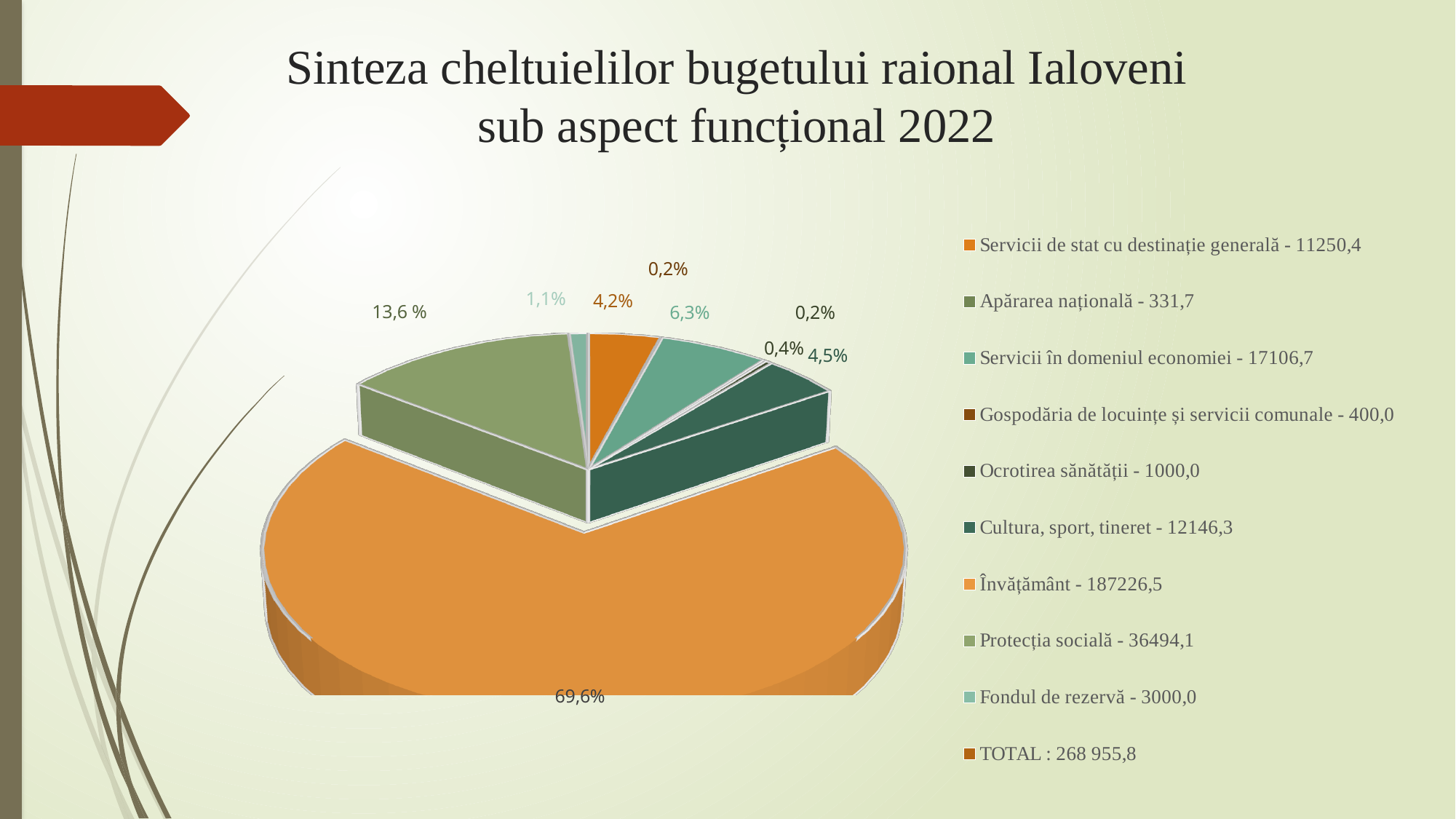
What share of the pie does Protecția socială represent? 13,6 % What TOTAL value is shown in the legend? 268 955,8 What type of chart is shown on the slide? pie chart Which category has the smallest value in the legend? Apărarea națională Which is larger: Servicii de stat cu destinație generală or Cultura, sport, tineret? Cultura, sport, tineret Which category has the largest share of the pie? Învățământ How many expenditure categories (excluding the TOTAL entry) does the legend list? 9 What is the difference between Servicii în domeniul economiei and Cultura, sport, tineret? 4960,4 What value does the legend give for Fondul de rezervă? 3000,0 What value does the legend give for Cultura, sport, tineret? 12146,3 What value does the legend give for Servicii în domeniul economiei? 17106,7 What share of the pie does Învățământ represent? 69,6%